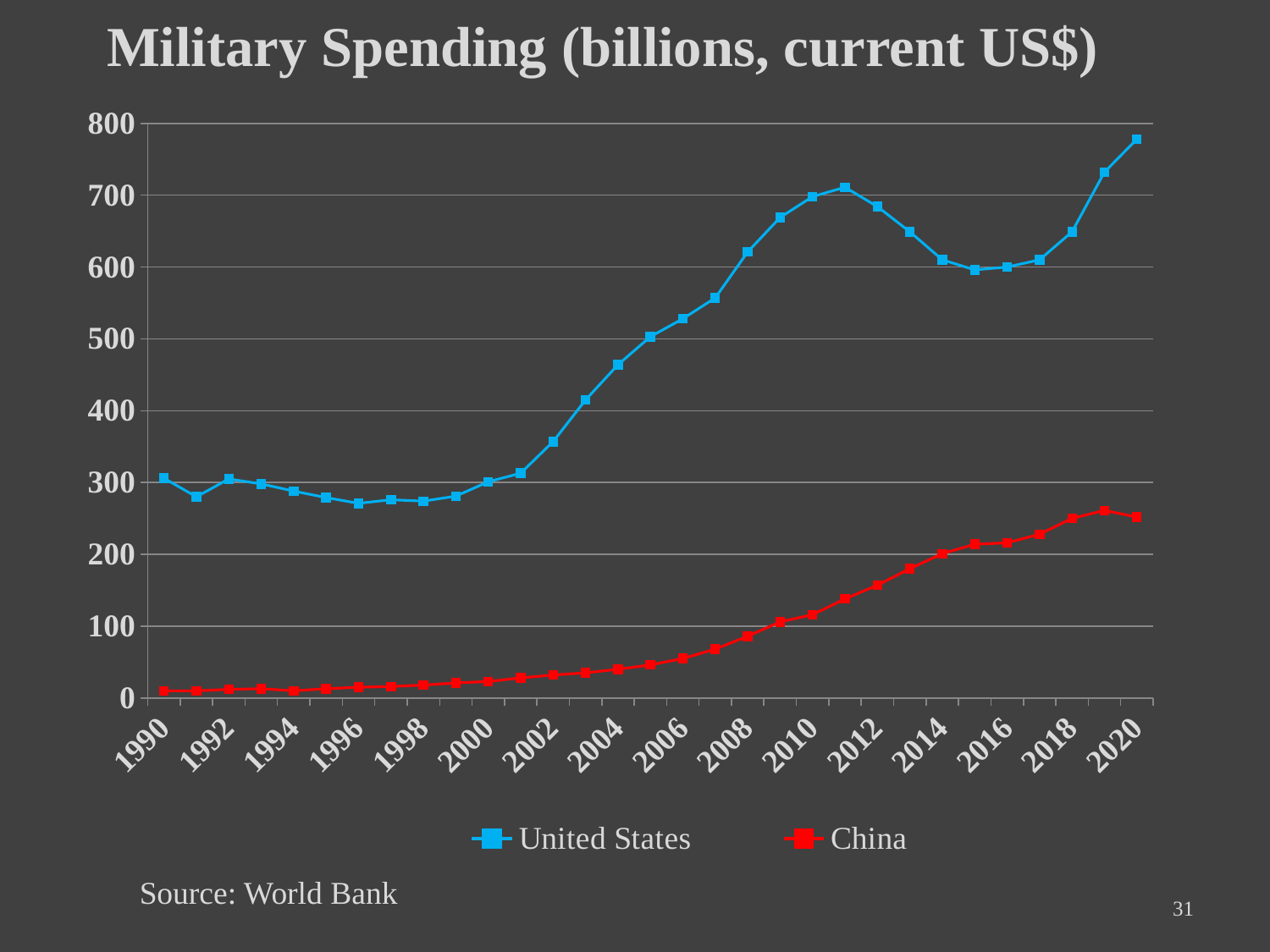
Is the value for the United States in 2020 greater or less than 700? greater In which year does the United States series reach its highest value? 2020 Is the value for the United States in 1997 greater or less than 300? less How many years are labeled on the x axis? 16 How many series does the legend list? 2 Which two series are shown in the legend? United States and China What kind of chart is shown on the slide? line chart Does the United States series rise or fall between 2011 and 2015? fall What is the title of the chart? Military Spending (billions, current US$) Is the value for China in 2020 greater or less than 200? greater Which series has the larger value in 2010, United States or China? United States